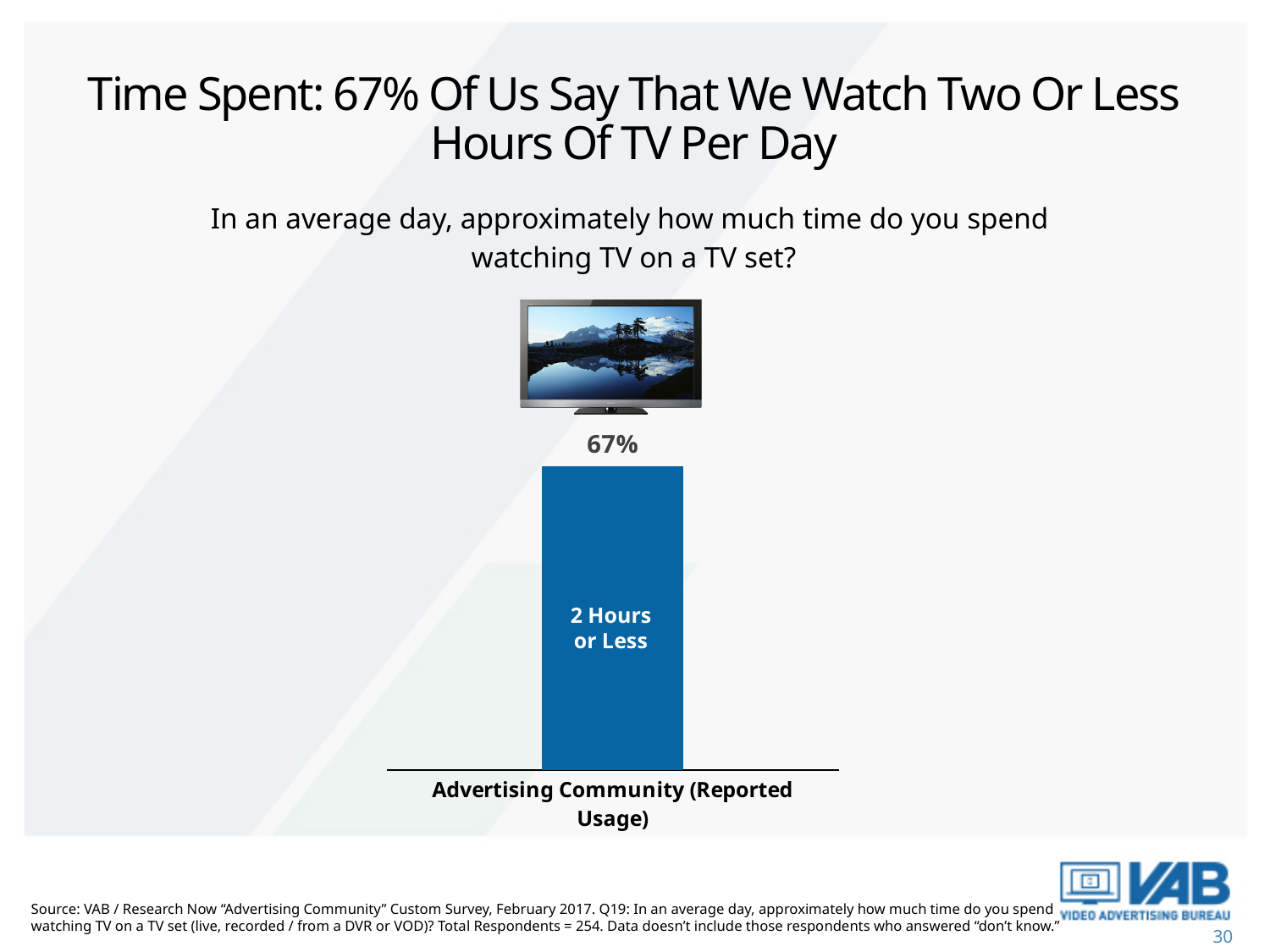
How many bars are plotted in the chart? 1 What value is printed above the bar in the chart? 67% What label is printed inside the bar? 2 Hours or Less What percentage of the advertising community reports watching 2 hours or less of TV per day on a TV set? 67% What is the category label shown beneath the bar on the x axis? Advertising Community (Reported Usage) What kind of chart is shown on the slide? bar chart